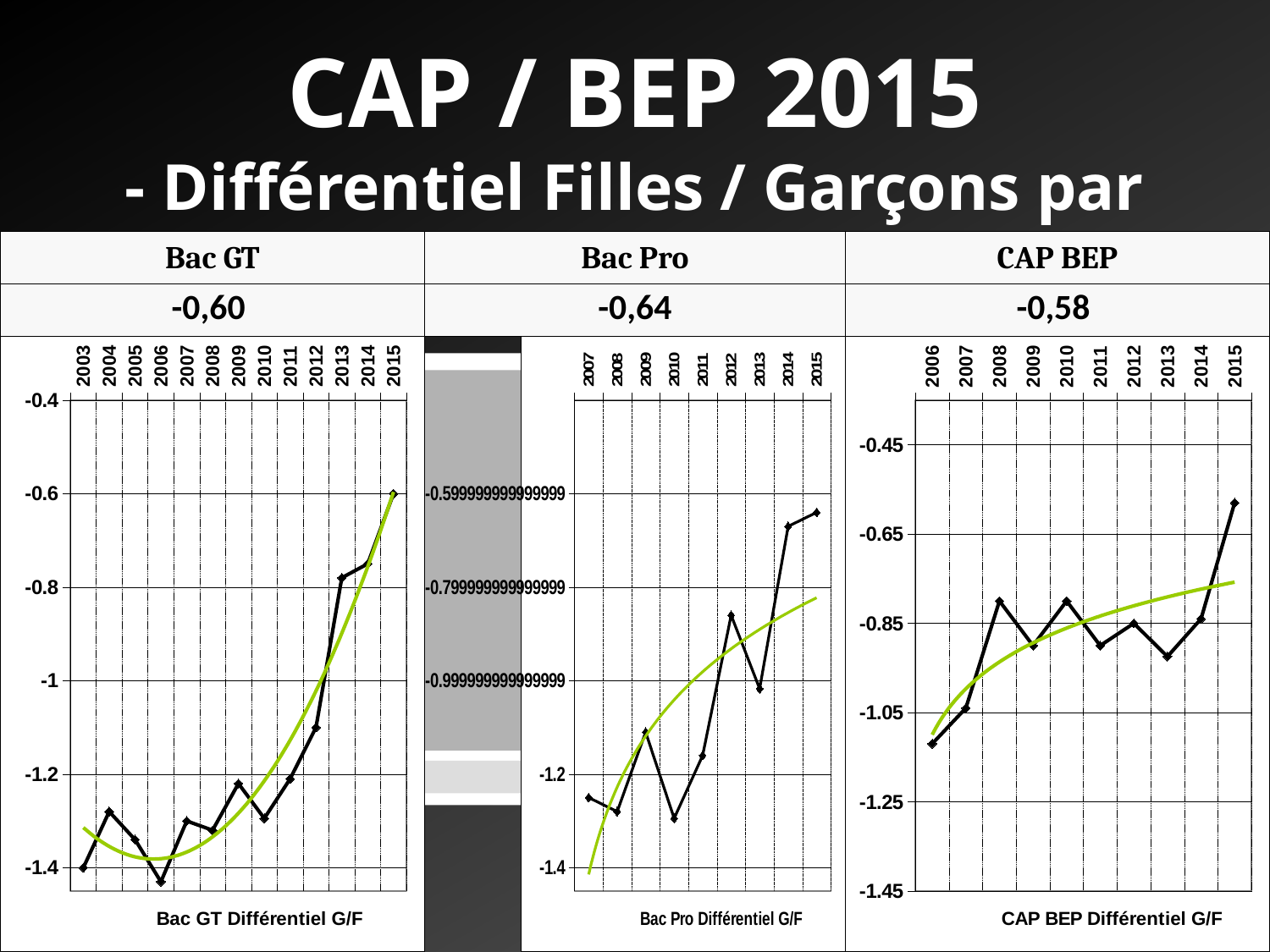
In the 'Bac GT Différentiel G/F' chart, do the values overall rise or fall from 2003 to 2015? rise In the 'Bac Pro Différentiel G/F' chart, how many years are plotted on the x axis? 9 In the 'CAP BEP Différentiel G/F' chart, which year has the highest value? 2015 In the 'Bac GT Différentiel G/F' chart, what is the value for 2015? -0.6 In the 'CAP BEP Différentiel G/F' chart, is the value for 2015 greater or less than -0.65? greater In the 'Bac Pro Différentiel G/F' chart, is the value for 2010 greater or less than -1.2? less How many charts are shown on the slide? 3 In the 'Bac GT Différentiel G/F' chart, is the value for 2012 greater or less than -1? less In the 'Bac GT Différentiel G/F' chart, how many years are plotted on the x axis? 13 In the 'Bac GT Différentiel G/F' chart, which year has the highest value? 2015 In the 'CAP BEP Différentiel G/F' chart, how many years are plotted on the x axis? 10 What kind of chart is the 'Bac GT Différentiel G/F' chart? line chart